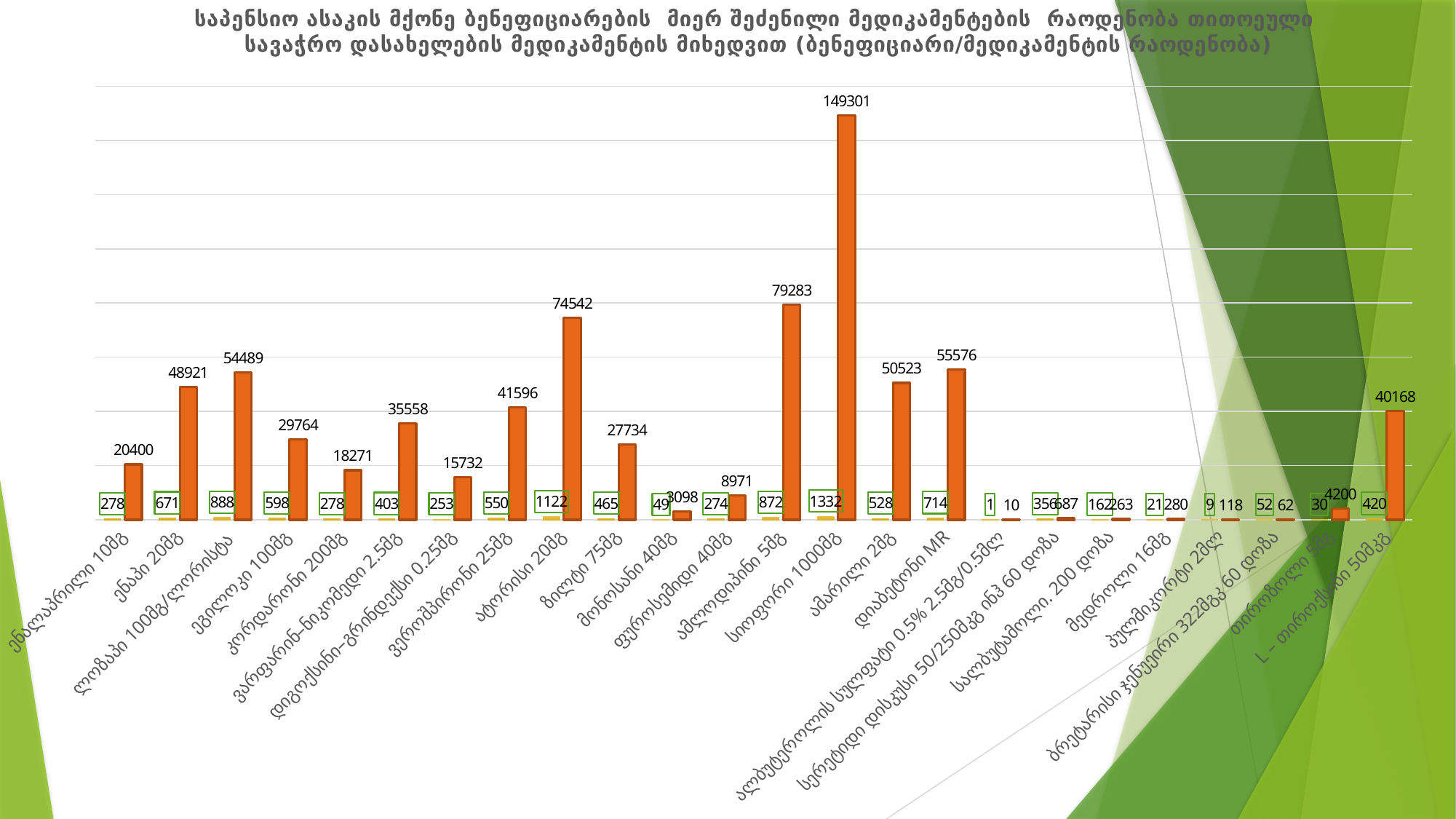
What is the medication count (orange bar) for ამლოდიპინი 5მგ? 79283 What is the medication count (orange bar) for L – თიროქსინი 50მკგ? 40168 Which category has the lowest medication count (orange bar)? ალბუტეროლის სულფატი 0.5% 2.5მგ/0.5მლ How many categories (medications) are shown on the x axis? 24 What is the beneficiary count (boxed label) for სიოფორი 1000მგ? 1332 Which category has the highest medication count (orange bar)? სიოფორი 1000მგ What is the medication count (orange bar) for ატორისი 20მგ? 74542 What kind of chart is shown on the slide? bar chart What is the value of the tallest orange bar, for სიოფორი 1000მგ? 149301 What is the difference between the medication counts of დიაბეტონი MR (55576) and ამარილი 2მგ (50523)? 5053 Which has a larger medication count: ენაპი 20მგ or ლოზაპი 100მგ/ლორისტა? ლოზაპი 100მგ/ლორისტა What is the difference between the medication counts of ამლოდიპინი 5მგ (79283) and ატორისი 20მგ (74542)? 4741